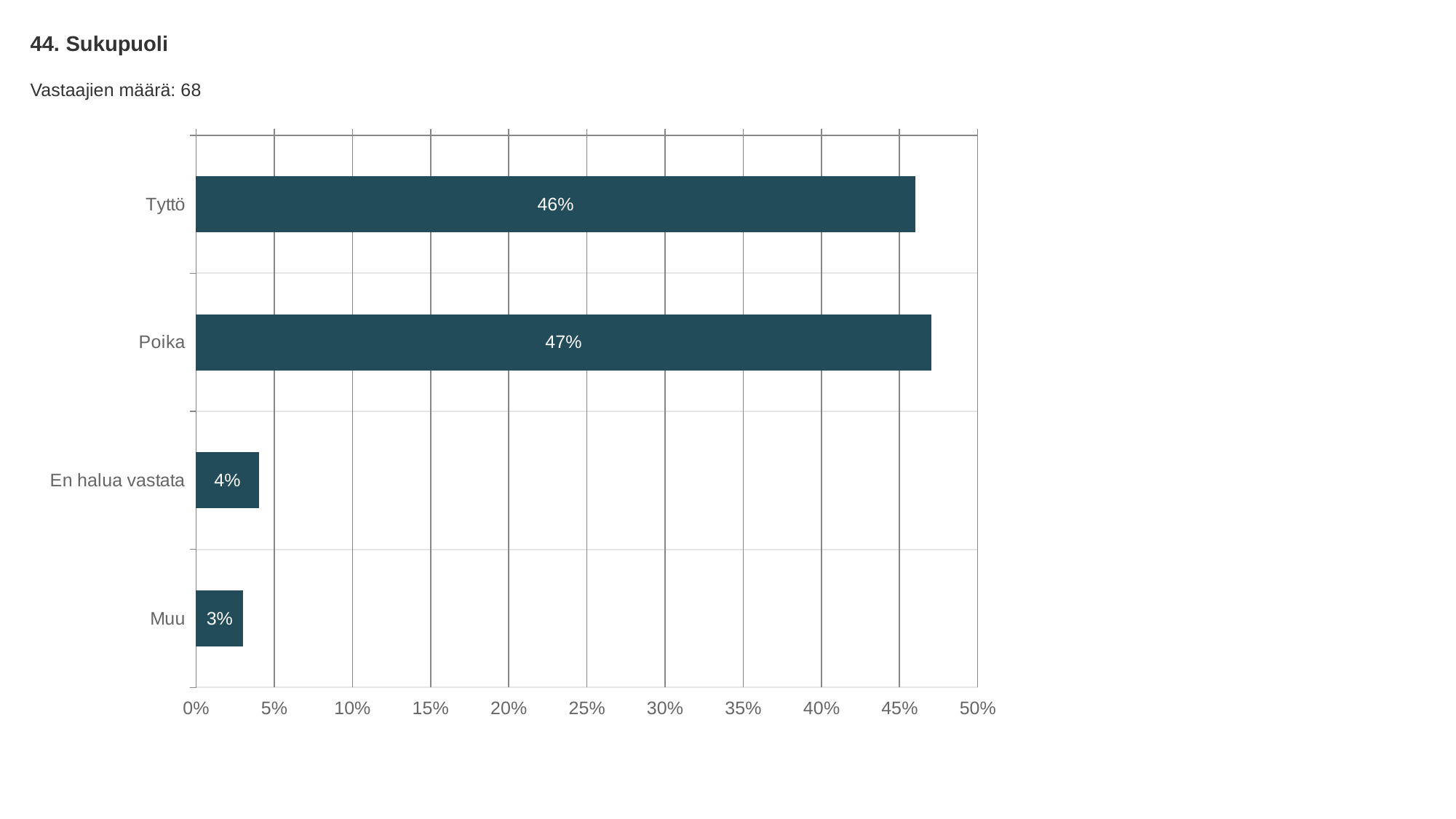
What is the title of the chart? 44. Sukupuoli Which category has the highest value? Poika What is the difference between the values for Tyttö and Muu? 43% How many categories are shown in the chart? 4 What is the value for Poika? 47% What is the difference between the values for Poika and Tyttö? 1% What is the value for Tyttö? 46% What kind of chart is shown on the slide? Bar chart Which is larger, the value for En halua vastata or the value for Muu? En halua vastata What is the value for Muu? 3% What is the value for En halua vastata? 4% Which category has the lowest value? Muu